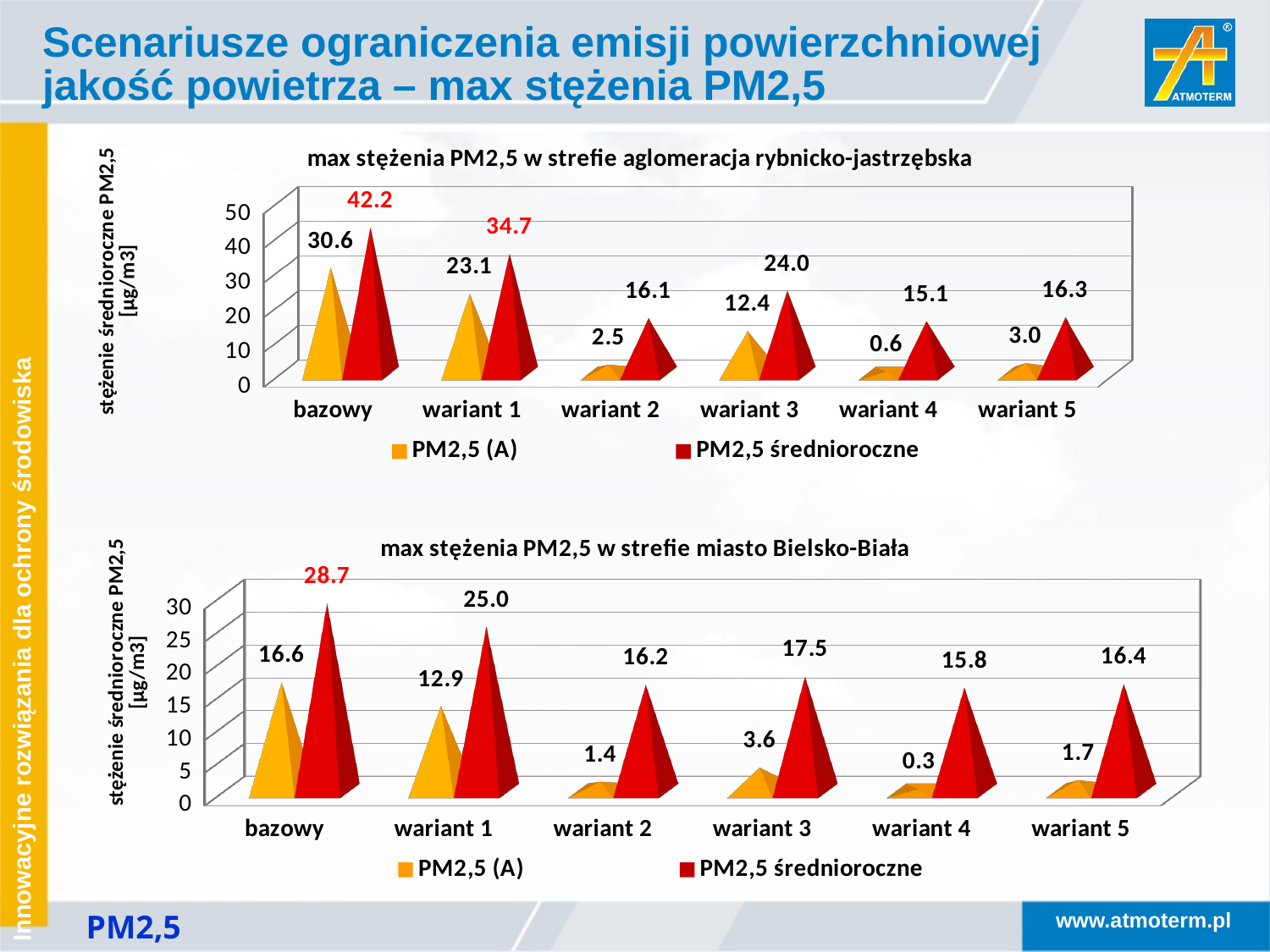
What kind of chart is the top chart on the slide? bar chart In the chart 'max stężenia PM2,5 w strefie miasto Bielsko-Biała', which category has the highest PM2,5 średnioroczne value? bazowy In the chart 'max stężenia PM2,5 w strefie miasto Bielsko-Biała', which is larger: the PM2,5 (A) value for wariant 1 or for wariant 3? wariant 1 In the chart 'max stężenia PM2,5 w strefie aglomeracja rybnicko-jastrzębska', what is the value of PM2,5 średnioroczne for bazowy? 42.2 In the chart 'max stężenia PM2,5 w strefie miasto Bielsko-Biała', what is the difference between the PM2,5 średnioroczne and PM2,5 (A) values for bazowy? 12.1 In the chart 'max stężenia PM2,5 w strefie miasto Bielsko-Biała', what is the value of PM2,5 średnioroczne for wariant 3? 17.5 In the chart 'max stężenia PM2,5 w strefie aglomeracja rybnicko-jastrzębska', which category has the lowest PM2,5 (A) value? wariant 4 In the chart 'max stężenia PM2,5 w strefie aglomeracja rybnicko-jastrzębska', what is the difference between the PM2,5 średnioroczne values for bazowy and wariant 1? 7.5 In the chart 'max stężenia PM2,5 w strefie aglomeracja rybnicko-jastrzębska', what is the value of PM2,5 (A) for wariant 3? 12.4 How many series does the legend of the chart 'max stężenia PM2,5 w strefie miasto Bielsko-Biała' list? 2 In the chart 'max stężenia PM2,5 w strefie aglomeracja rybnicko-jastrzębska', how many categories are shown on the x axis? 6 In the chart 'max stężenia PM2,5 w strefie miasto Bielsko-Biała', what is the value of PM2,5 (A) for wariant 4? 0.3